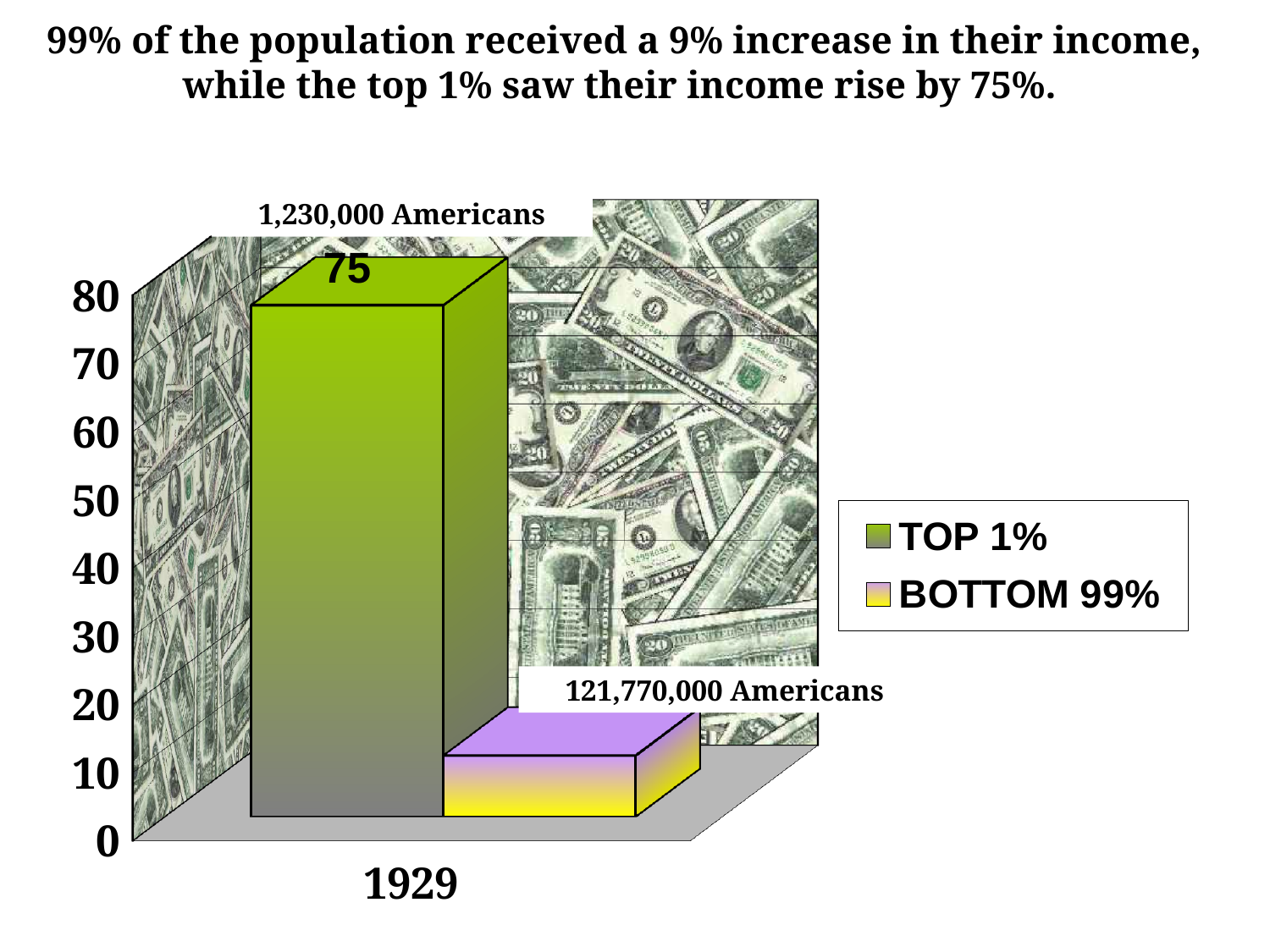
What text label appears above the BOTTOM 99% bar? 121,770,000 Americans Which series has the highest bar in 1929? TOP 1% What is the highest value shown on the vertical axis? 80 How many series does the legend list? 2 Is the value for TOP 1% greater or less than 70? greater What kind of chart is shown on the slide? bar chart Is the value for BOTTOM 99% greater or less than 10? less What text label appears above the TOP 1% bar? 1,230,000 Americans Which series has the lowest bar in 1929? BOTTOM 99% How many categories are shown on the x axis of the chart? 1 Which is larger in 1929, the TOP 1% bar or the BOTTOM 99% bar? TOP 1% What is the value shown for the TOP 1% bar in 1929? 75